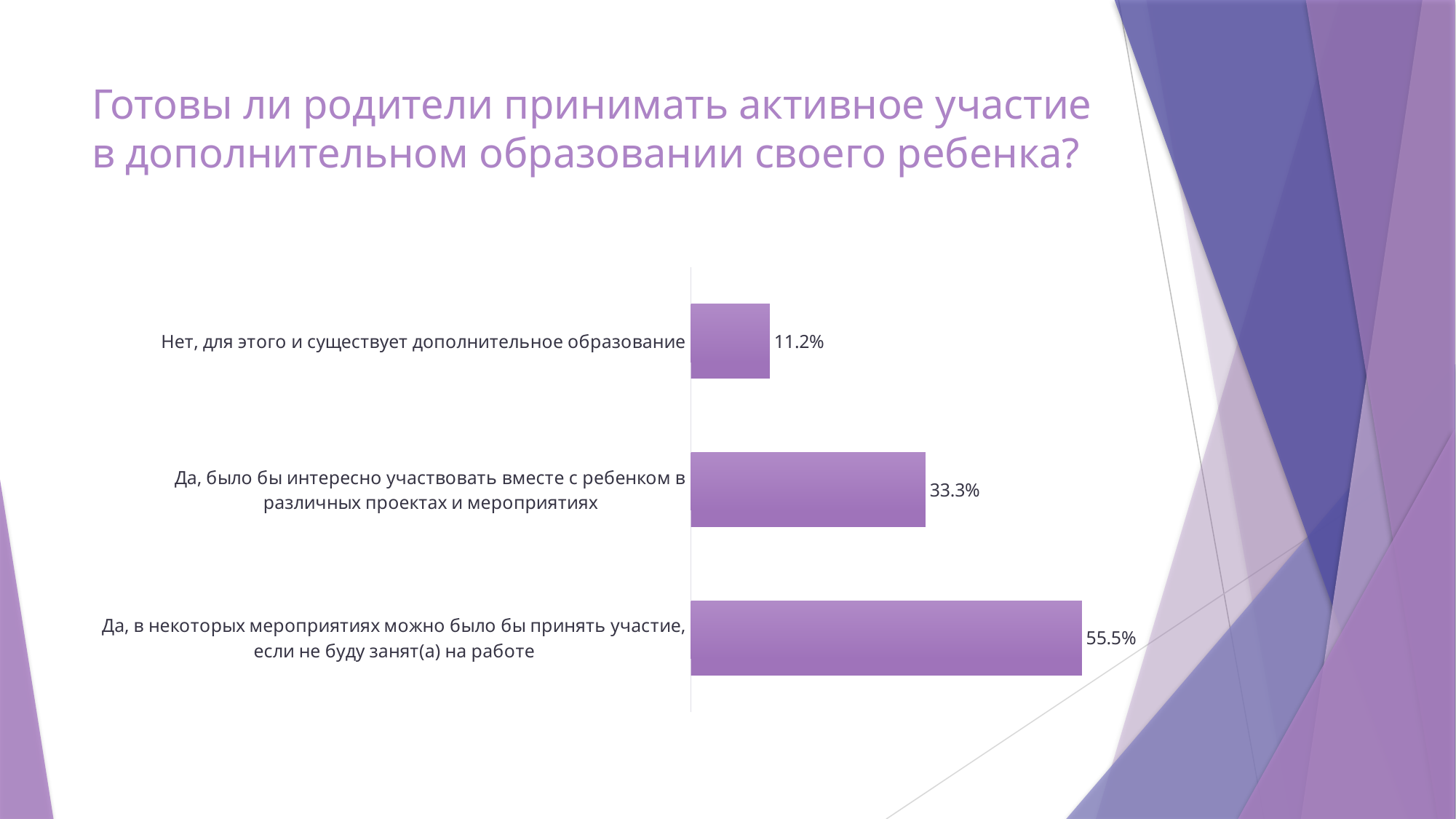
How many categories are shown in the chart? 3 Which category has the lowest value? Нет, для этого и существует дополнительное образование What is the value for "Нет, для этого и существует дополнительное образование"? 11.2% What is the value for "Да, было бы интересно участвовать вместе с ребенком в различных проектах и мероприятиях"? 33.3% What is the difference between the values for "Да, в некоторых мероприятиях можно было бы принять участие, если не буду занят(а) на работе" and "Да, было бы интересно участвовать вместе с ребенком в различных проектах и мероприятиях"? 22.2% Which category has the highest value? Да, в некоторых мероприятиях можно было бы принять участие, если не буду занят(а) на работе What is the title of the slide containing the chart? Готовы ли родители принимать активное участие в дополнительном образовании своего ребенка? Which is larger: the value for "Да, было бы интересно участвовать вместе с ребенком в различных проектах и мероприятиях" or the value for "Нет, для этого и существует дополнительное образование"? Да, было бы интересно участвовать вместе с ребенком в различных проектах и мероприятиях What is the difference between the values for "Да, было бы интересно участвовать вместе с ребенком в различных проектах и мероприятиях" and "Нет, для этого и существует дополнительное образование"? 22.1% What kind of chart is shown on the slide? Bar chart What colour are the bars in the chart? Purple What is the value for "Да, в некоторых мероприятиях можно было бы принять участие, если не буду занят(а) на работе"? 55.5%